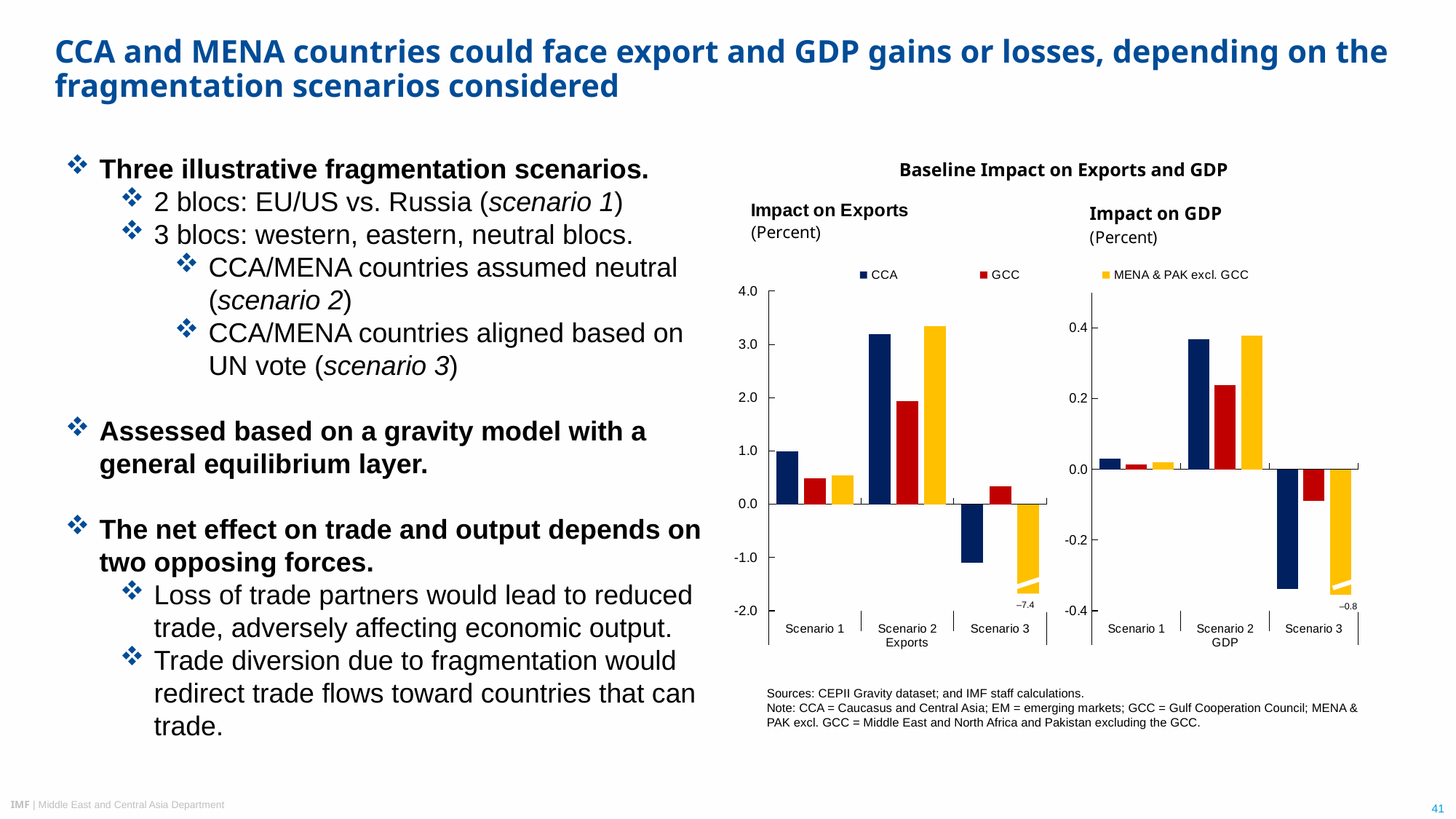
How many scenarios are shown on the x axis of the Impact on GDP chart? 3 In the Impact on Exports chart, which is larger in Scenario 2: CCA or GCC? CCA What kind of chart is the Impact on Exports chart? Bar chart How many series does the legend list for the charts? 3 In the Impact on Exports chart, what is the value for MENA & PAK excl. GCC in Scenario 3? –7.4 In the Impact on GDP chart, what is the value for MENA & PAK excl. GCC in Scenario 3? –0.8 In the Impact on GDP chart, which is larger in Scenario 2: CCA or GCC? CCA In the Impact on Exports chart, which scenario has the highest value for CCA? Scenario 2 In the Impact on GDP chart, is the value for CCA in Scenario 3 greater or less than -0.2? less What is the overall title above the two charts? Baseline Impact on Exports and GDP In the Impact on Exports chart, is the value for CCA in Scenario 2 greater or less than 3.0? greater